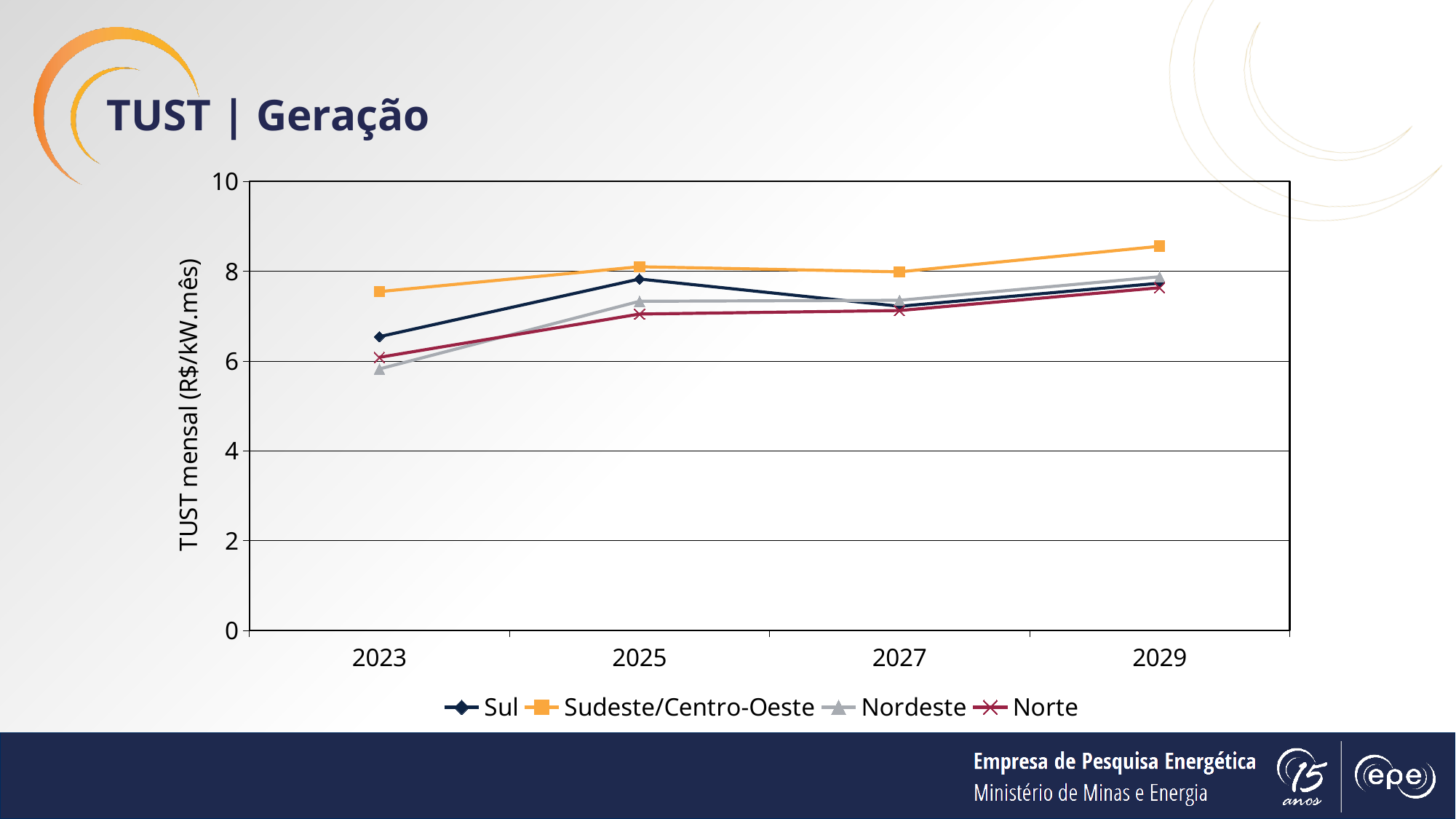
What is the label of the y axis? TUST mensal (R$/kW.mês) In 2023, which is larger: the value for Sul or the value for Norte? Sul Which series has the highest value in 2029? Sudeste/Centro-Oeste Is the value for Norte in 2025 greater or less than 8? less Which series has the lowest value in 2023? Nordeste Does the Sudeste/Centro-Oeste series rise or fall from 2027 to 2029? rise How many series does the legend list? 4 What kind of chart is shown on the slide? line chart Which series has the highest value in 2023? Sudeste/Centro-Oeste How many years are shown on the x axis? 4 Is the value for Sul in 2023 greater or less than 6? greater Is the value for Sudeste/Centro-Oeste in 2029 greater or less than 8? greater